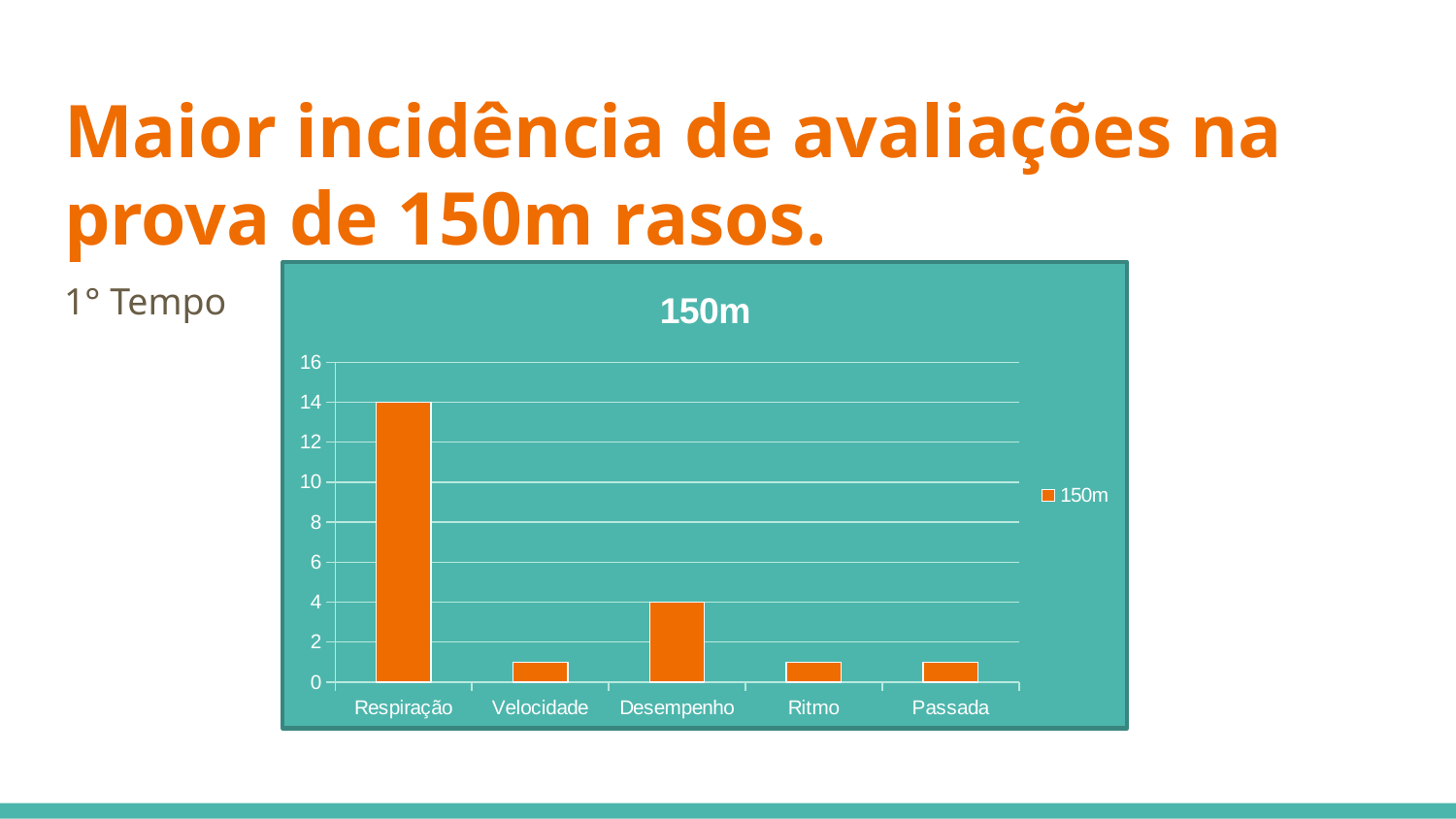
What kind of chart is shown on the slide? bar chart What colour are the bars in the chart? orange What is the value for Respiração? 14 Is the value for Velocidade greater or less than 2? less Which is larger, the value for Desempenho or the value for Velocidade? Desempenho Is the value for Respiração greater or less than 10? greater What is the value for Desempenho? 4 What is the title of the chart? 150m Which category has the highest value in the chart? Respiração How many categories are shown on the x axis of the chart? 5 What is the difference between the values for Respiração and Desempenho? 10 How many series does the chart legend list? 1